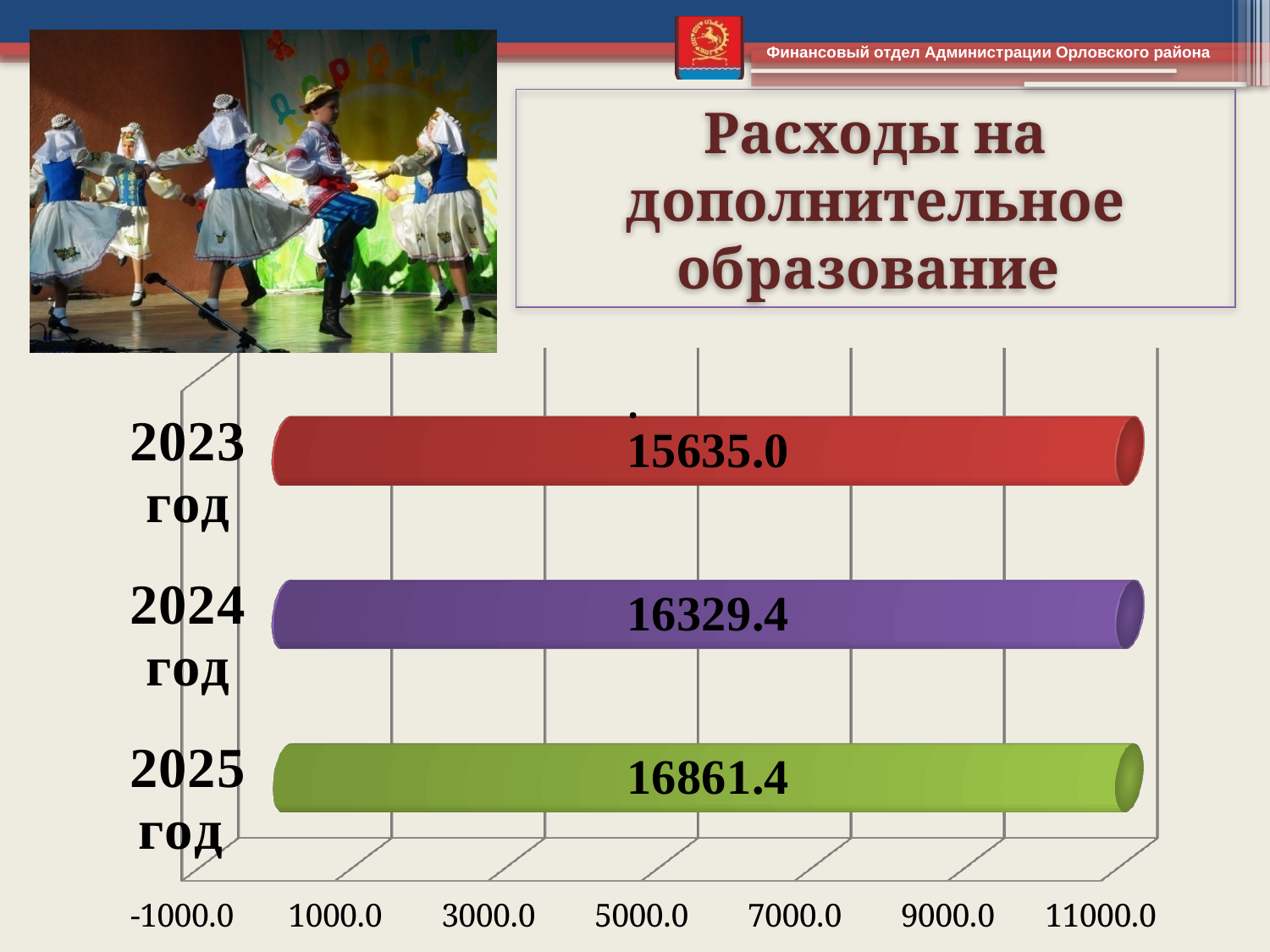
What is the value for 2024 год? 16329.4 What is the value for 2025 год? 16861.4 What is the title of the chart? Расходы на дополнительное образование Do the values rise or fall from 2023 год to 2025 год? rise Which year has the highest value? 2025 год What is the difference between the values for 2024 год and 2023 год? 694.4 How many years are shown in the chart? 3 What kind of chart is shown on the slide? bar chart Which year has the lowest value? 2023 год Which is larger, the value for 2025 год or the value for 2023 год? 2025 год What is the difference between the values for 2025 год and 2024 год? 532.0 What is the value for 2023 год? 15635.0